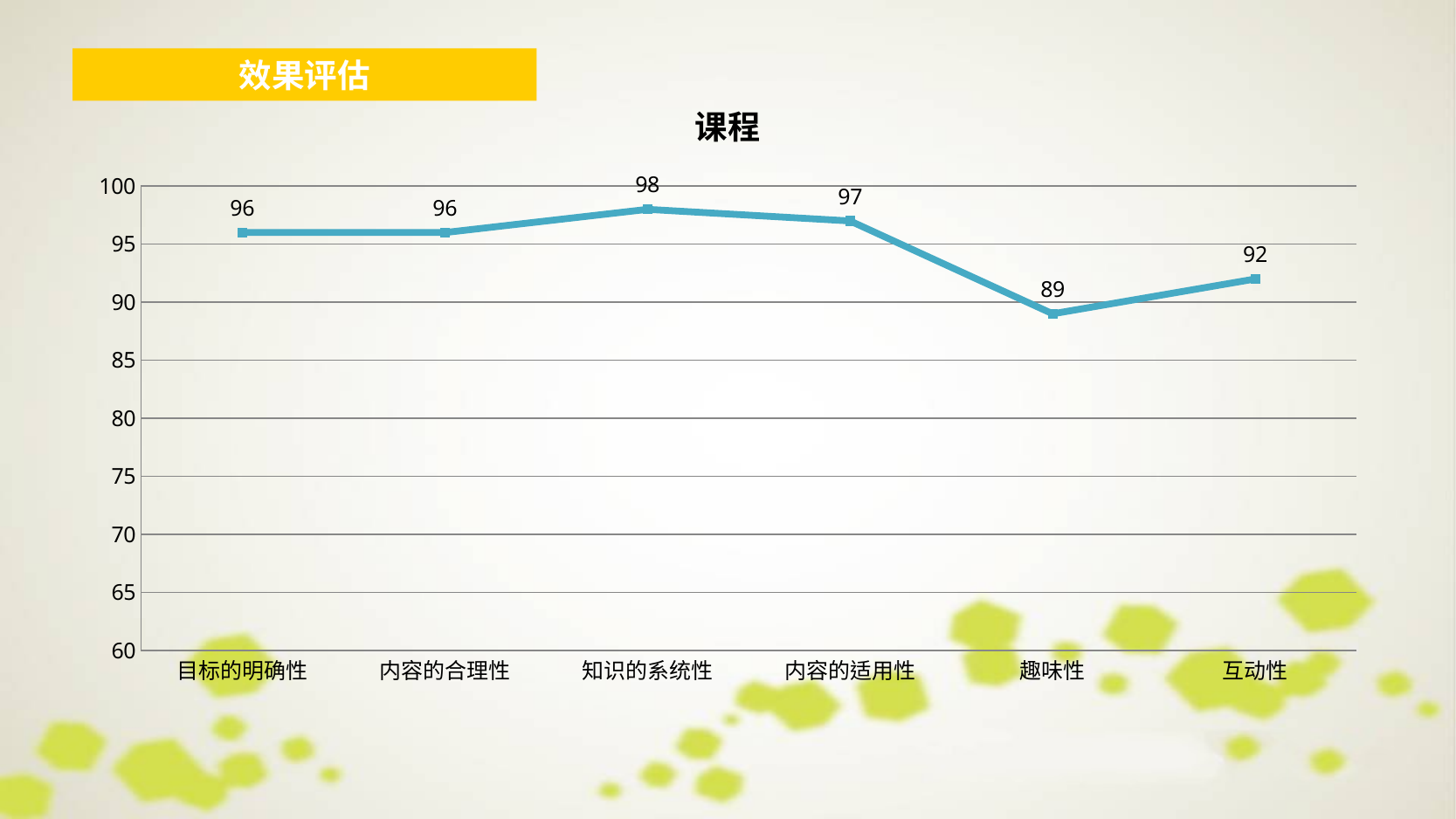
Which category has the lowest value? 趣味性 What is the title of the chart? 课程 What is the value for 内容的适用性? 97 What is the value for 互动性? 92 Which is larger, the value for 内容的适用性 or the value for 互动性? 内容的适用性 What is the difference between the values for 知识的系统性 and 趣味性? 9 What is the value for 趣味性? 89 What kind of chart is shown on the slide? line chart How many categories are plotted on the x axis? 6 Which category has the highest value? 知识的系统性 What is the value for 知识的系统性? 98 Do the values rise or fall from 内容的适用性 to 趣味性? fall